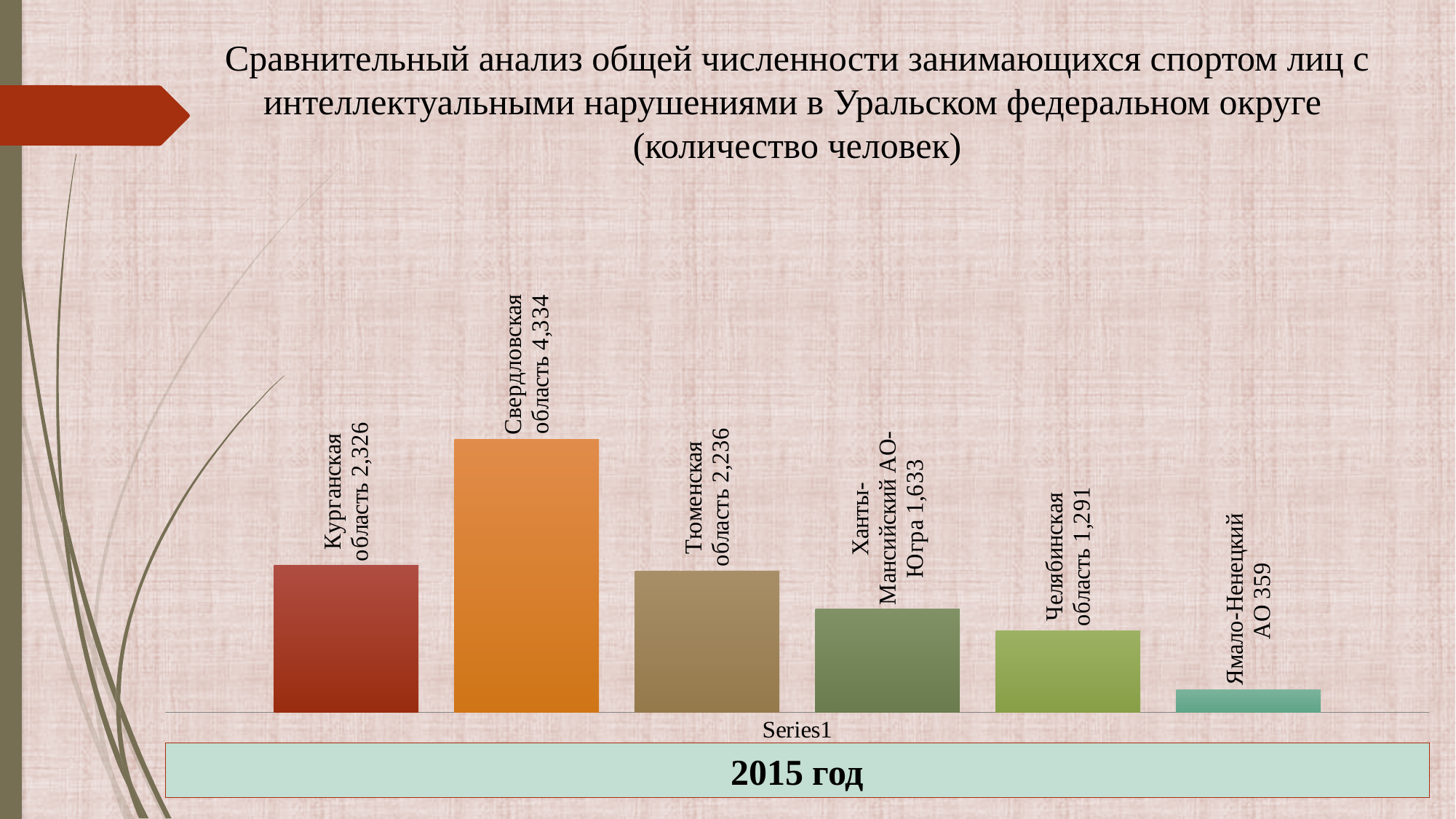
Which is larger, the value for Курганская область or the value for Тюменская область? Курганская область Which region has the highest value? Свердловская область What is the value for Ханты-Мансийский АО-Югра? 1,633 What is the value for Курганская область? 2,326 What is the difference between the values for Свердловская область and Курганская область? 2,008 What is the value for Ямало-Ненецкий АО? 359 What is the difference between the values for Тюменская область and Челябинская область? 945 What is the value for Свердловская область? 4,334 What year is indicated in the box below the chart? 2015 год Which region has the lowest value? Ямало-Ненецкий АО What kind of chart is shown on the slide? Bar chart How many regions (bars) are shown in the chart? 6